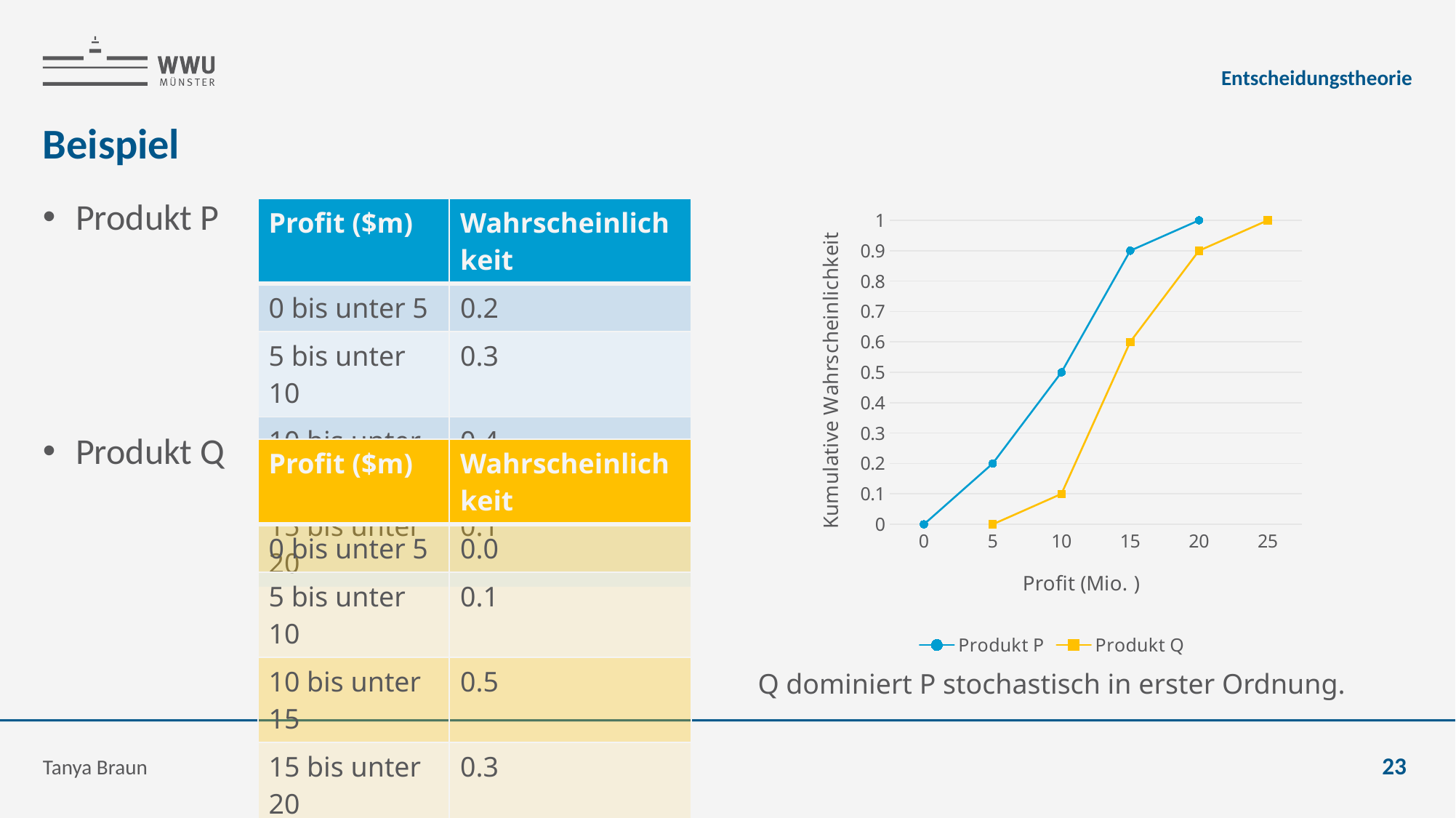
Do the cumulative probability values for Produkt P rise or fall as profit increases along the x axis? rise What is the difference between the cumulative probabilities of Produkt P and Produkt Q at a profit of 10? 0.4 How many series does the chart legend list? 2 What kind of chart is shown on the slide? line chart What is the label of the y axis of the chart? Kumulative Wahrscheinlichkeit How many data points are plotted for Produkt Q? 5 What is the cumulative probability for Produkt P at a profit of 15? 0.9 What is the cumulative probability for Produkt Q at a profit of 15? 0.6 What is the cumulative probability for Produkt Q at a profit of 10? 0.1 What are the names of the two series in the chart legend? Produkt P and Produkt Q At a profit of 15, which series has the higher cumulative probability, Produkt P or Produkt Q? Produkt P What is the cumulative probability for Produkt P at a profit of 10? 0.5